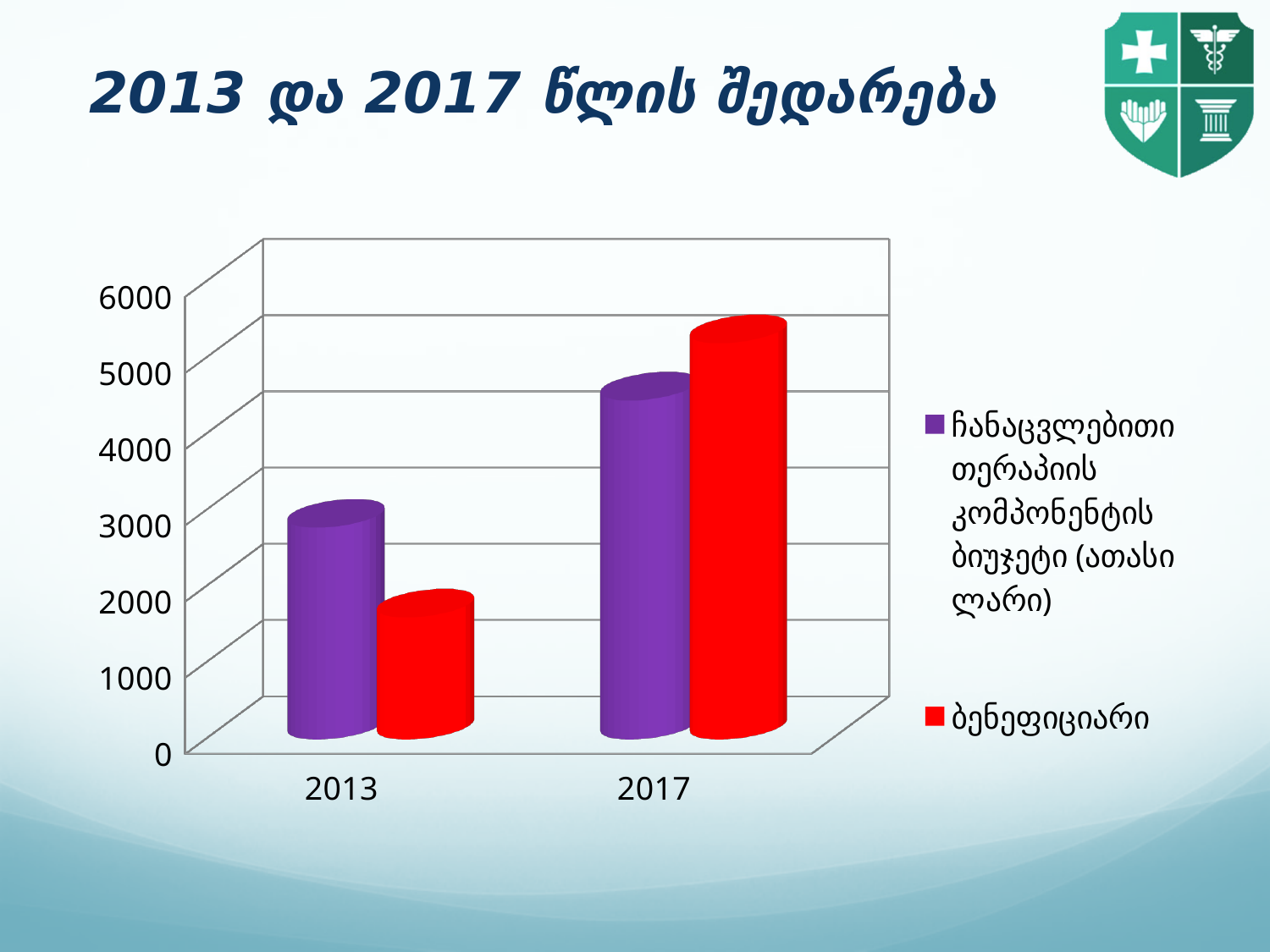
What kind of chart is shown on the slide? bar chart Which colour represents the ბენეფიციარი series? red Is the value for ბენეფიციარი in 2017 greater or less than 5000? greater How many categories are shown on the x axis? 2 How many series does the legend list? 2 In 2013, which series has the larger value, ჩანაცვლებითი თერაპიის კომპონენტის ბიუჯეტი (ათასი ლარი) or ბენეფიციარი? ჩანაცვლებითი თერაპიის კომპონენტის ბიუჯეტი (ათასი ლარი) Is the value for ჩანაცვლებითი თერაპიის კომპონენტის ბიუჯეტი (ათასი ლარი) in 2013 greater or less than 2000? greater Which two years are compared on the x axis? 2013 and 2017 Is the value for ბენეფიციარი in 2013 greater or less than 3000? less Do the values for ბენეფიციარი rise or fall from 2013 to 2017? rise In 2017, which series has the larger value, ჩანაცვლებითი თერაპიის კომპონენტის ბიუჯეტი (ათასი ლარი) or ბენეფიციარი? ბენეფიციარი